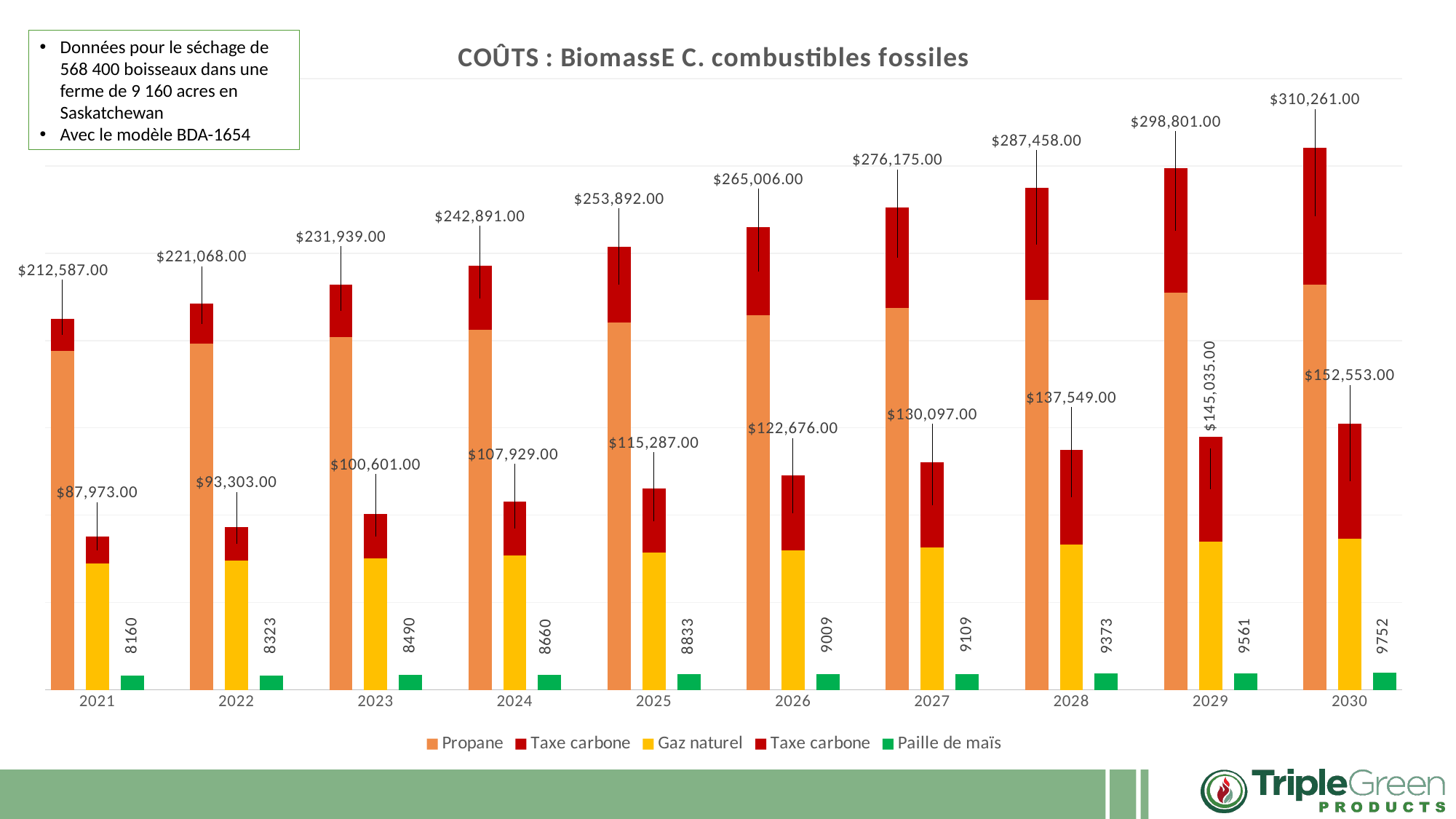
In which year is the propane stack total the highest? 2030 In which year is the Paille de maïs value the lowest? 2021 How many years are shown along the x axis? 10 How many entries does the legend list? 5 What value is labelled for Paille de maïs in 2030? 9752 What is the labelled total for the propane stack (Propane + Taxe carbone) in 2021? $212,587.00 What kind of chart is shown on the slide? Stacked bar chart In 2021, which is larger: the propane stack total or the natural gas stack total? The propane stack total What is the difference between the propane stack total in 2030 ($310,261.00) and in 2021 ($212,587.00)? $97,674.00 What is the chart's title? COÛTS : BiomassE C. combustibles fossiles Do the natural gas stack totals rise or fall from 2021 to 2030? Rise What is the labelled total for the natural gas stack (Gaz naturel + Taxe carbone) in 2025? $115,287.00